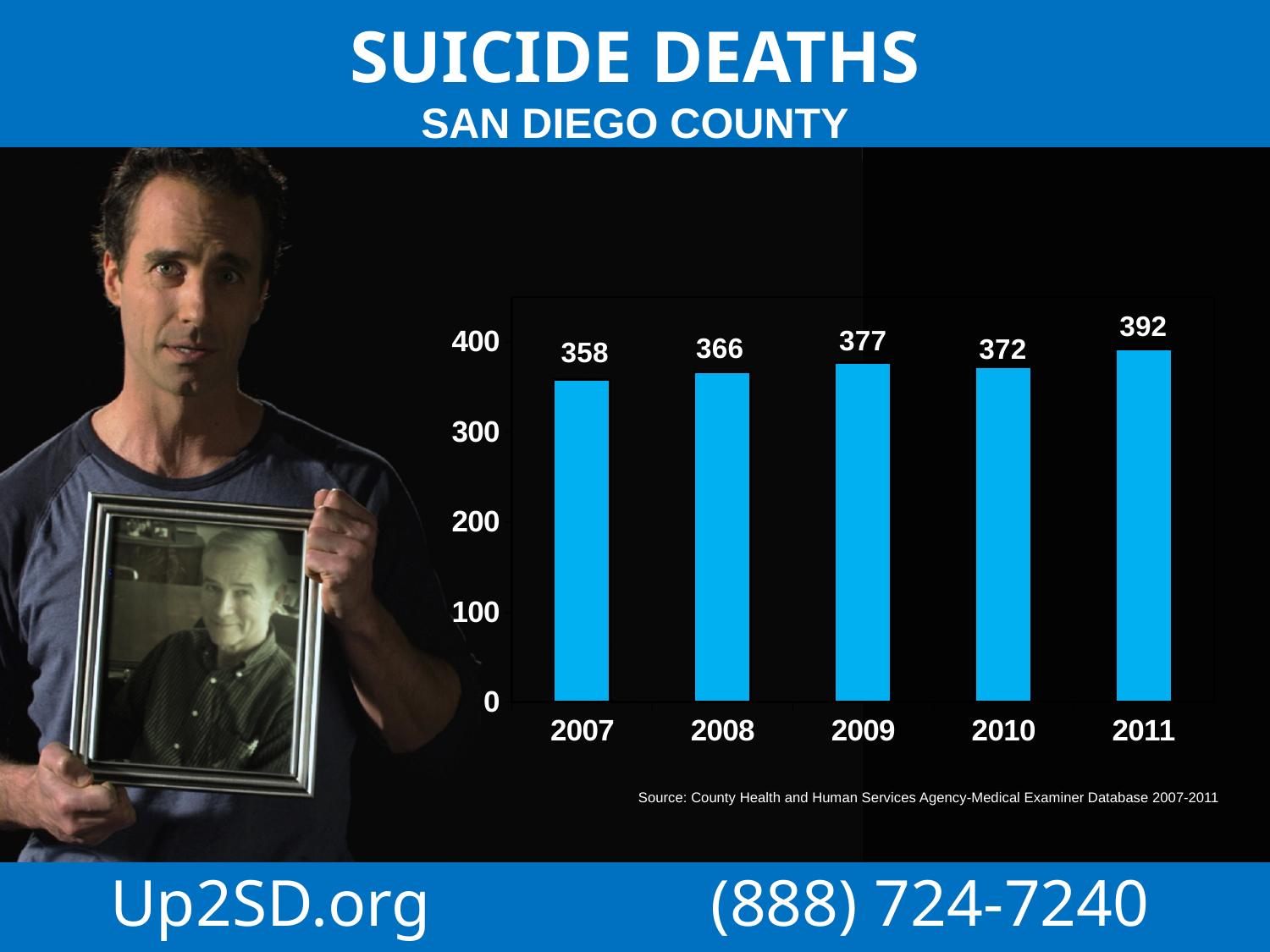
Which year has the highest number of suicide deaths? 2011 What is the difference between the values for 2009 and 2010? 5 What is the number of suicide deaths shown for 2011? 392 How many years are shown on the x axis of the chart? 5 What is the number of suicide deaths shown for 2009? 377 What is the title of the chart on the slide? SUICIDE DEATHS SAN DIEGO COUNTY Which year has a larger value, 2008 or 2010? 2010 What is the number of suicide deaths shown for 2007? 358 What is the difference between the values for 2011 and 2007? 34 What kind of chart is shown on the slide? bar chart Which year has the lowest number of suicide deaths? 2007 Is the value for 2010 greater or less than 300? greater